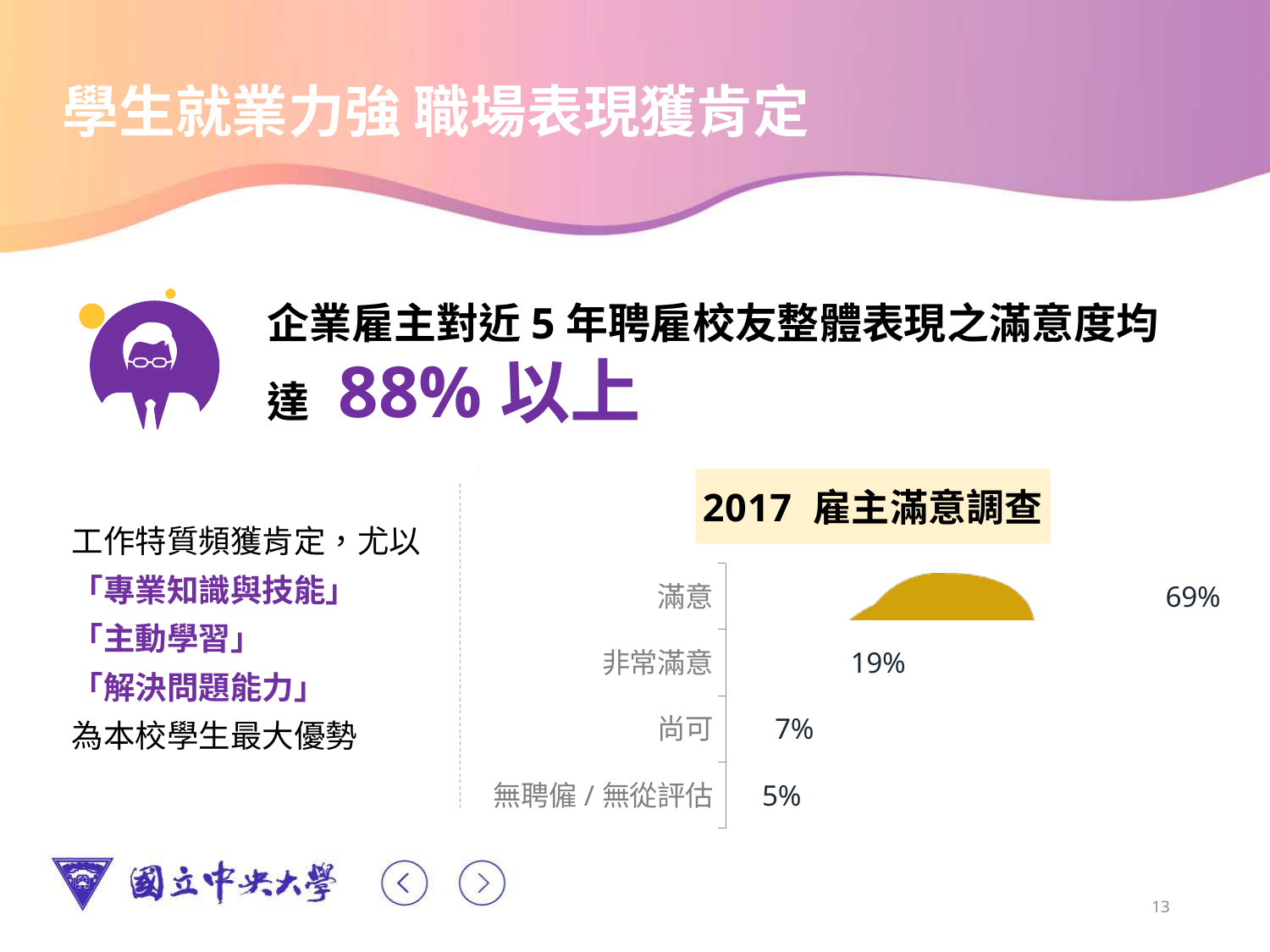
What is the value for 尚可 in the 2017 雇主滿意調查 chart? 7% What is the value for 滿意 in the 2017 雇主滿意調查 chart? 69% How many categories are shown in the 2017 雇主滿意調查 chart? 4 What is the value for 非常滿意 in the 2017 雇主滿意調查 chart? 19% What is the title of the chart on the slide? 2017 雇主滿意調查 Which category has the lowest value in the 2017 雇主滿意調查 chart? 無聘僱 / 無從評估 Which is larger in the 2017 雇主滿意調查 chart, the value for 非常滿意 or the value for 尚可? 非常滿意 Which category has the highest value in the 2017 雇主滿意調查 chart? 滿意 What kind of chart is the 2017 雇主滿意調查 chart? bar chart What is the difference between the values for 滿意 and 非常滿意 in the 2017 雇主滿意調查 chart? 50% What is the difference between the values for 尚可 and 無聘僱 / 無從評估 in the 2017 雇主滿意調查 chart? 2% What is the value for 無聘僱 / 無從評估 in the 2017 雇主滿意調查 chart? 5%